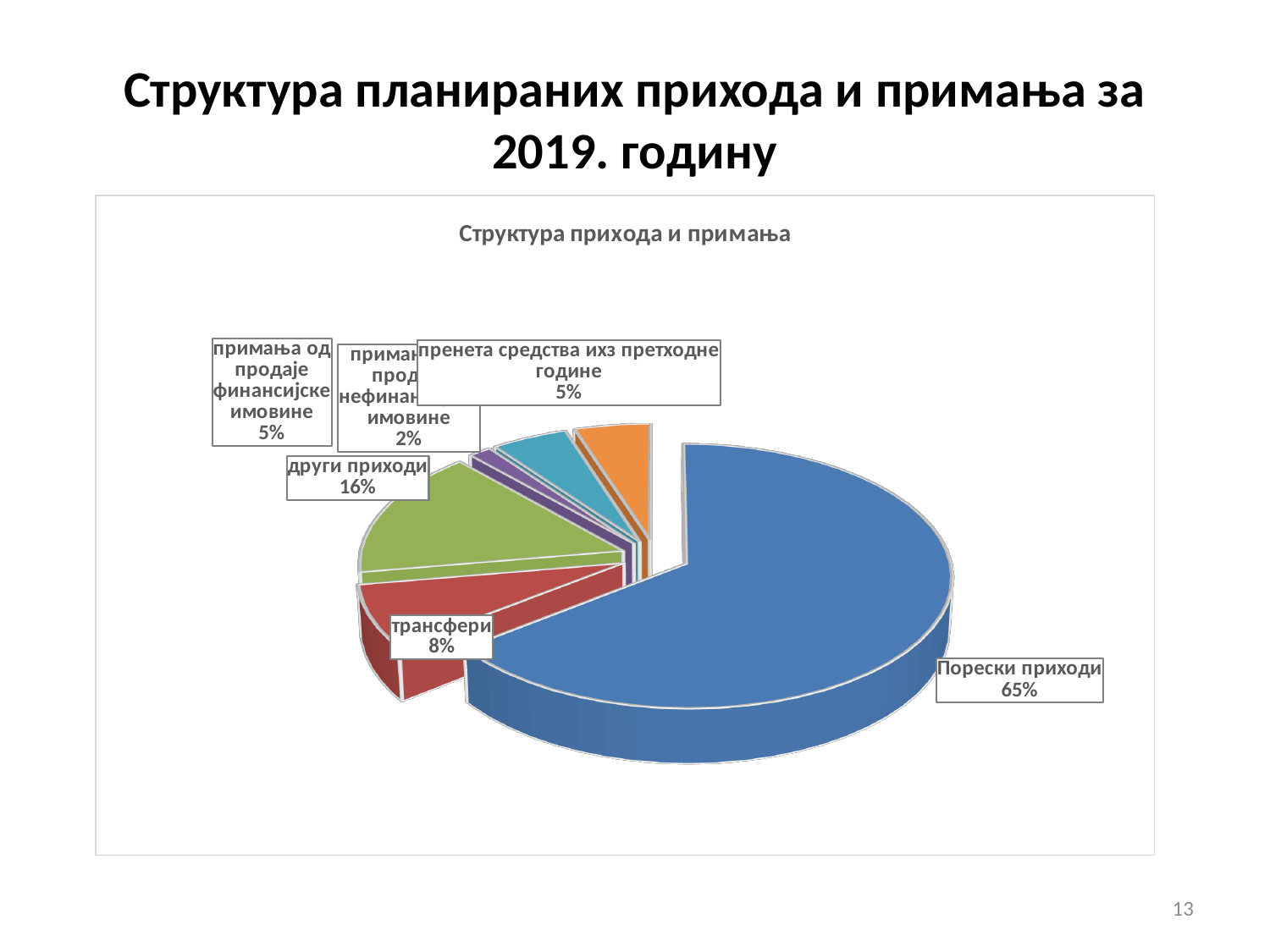
What share of the pie does Порески приходи represent? 65% Which is larger, the share for други приходи or the share for трансфери? други приходи How many slices does the pie chart have? 6 What type of chart is shown on the slide? Pie chart What percentage is shown for примања од продаје финансијске имовине? 5% What percentage is shown for други приходи? 16% What percentage is shown for пренета средства из претходне године? 5% Which category has the largest slice of the pie? Порески приходи What is the title of the chart? Структура прихода и примања What is the smallest percentage shown on the pie chart? 2% What is the difference in percentage points between Порески приходи and други приходи? 49 What percentage is shown for трансфери? 8%